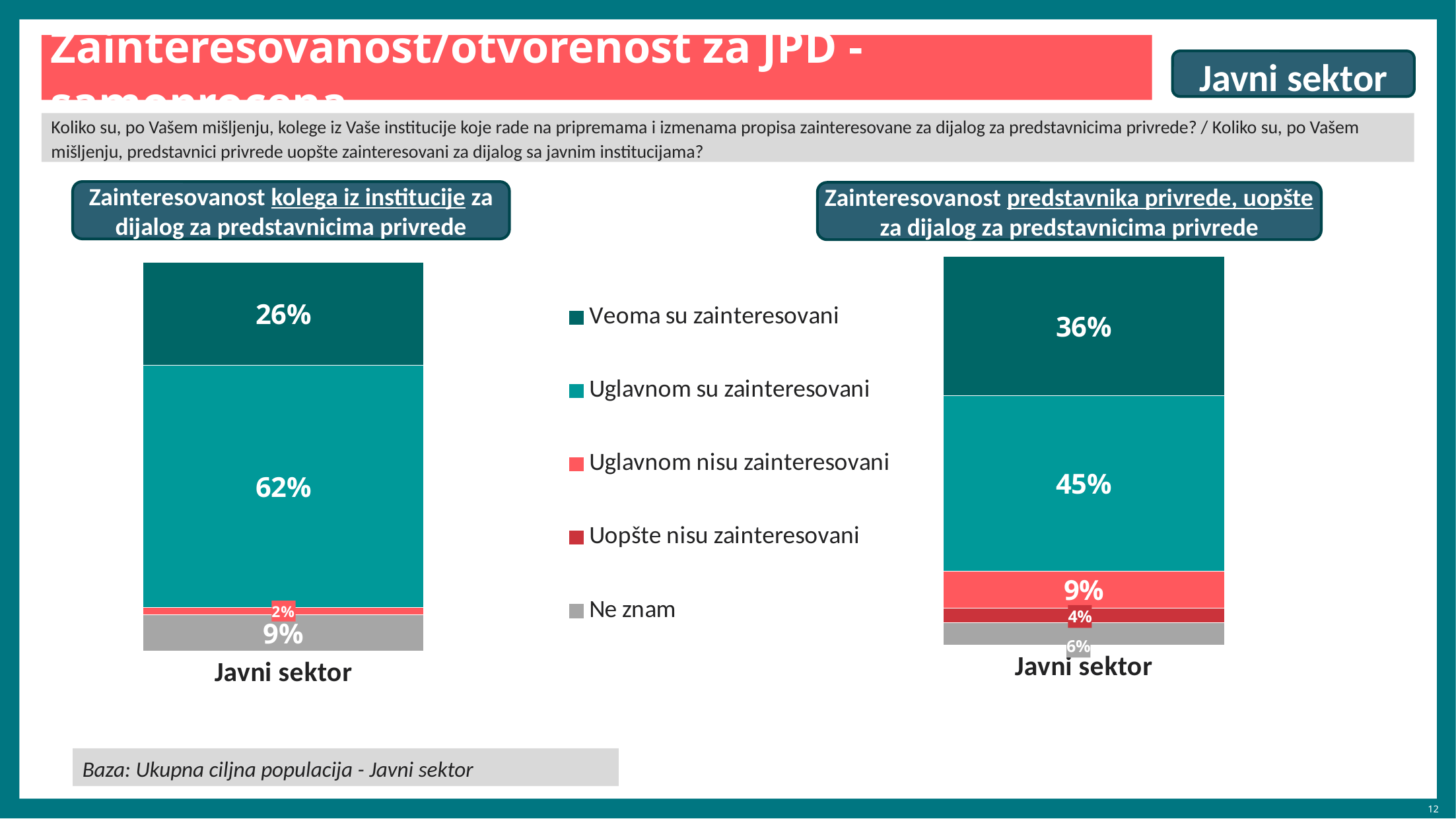
Which chart shows a larger value for 'Uglavnom su zainteresovani', the left chart or the right chart? The left chart In the left chart (Zainteresovanost kolega iz institucije), what percentage is shown for 'Ne znam'? 9% In the right chart (Zainteresovanost predstavnika privrede), which category has the largest share? Uglavnom su zainteresovani What type of chart is used on this slide? Stacked bar chart How many series does the legend list? 5 In the left chart (Zainteresovanost kolega iz institucije), what percentage is shown for 'Uglavnom su zainteresovani'? 62% In the right chart (Zainteresovanost predstavnika privrede), what is the total of the stacked bar? 100% In the right chart (Zainteresovanost predstavnika privrede), what percentage is shown for 'Uopšte nisu zainteresovani'? 4% In the right chart (Zainteresovanost predstavnika privrede), what percentage is shown for 'Veoma su zainteresovani'? 36% In the left chart (Zainteresovanost kolega iz institucije), which labelled category has the smallest share? Uglavnom nisu zainteresovani What is the difference between the 'Veoma su zainteresovani' values in the right chart and the left chart? 10 percentage points In the left chart (Zainteresovanost kolega iz institucije), what percentage is shown for 'Veoma su zainteresovani'? 26%